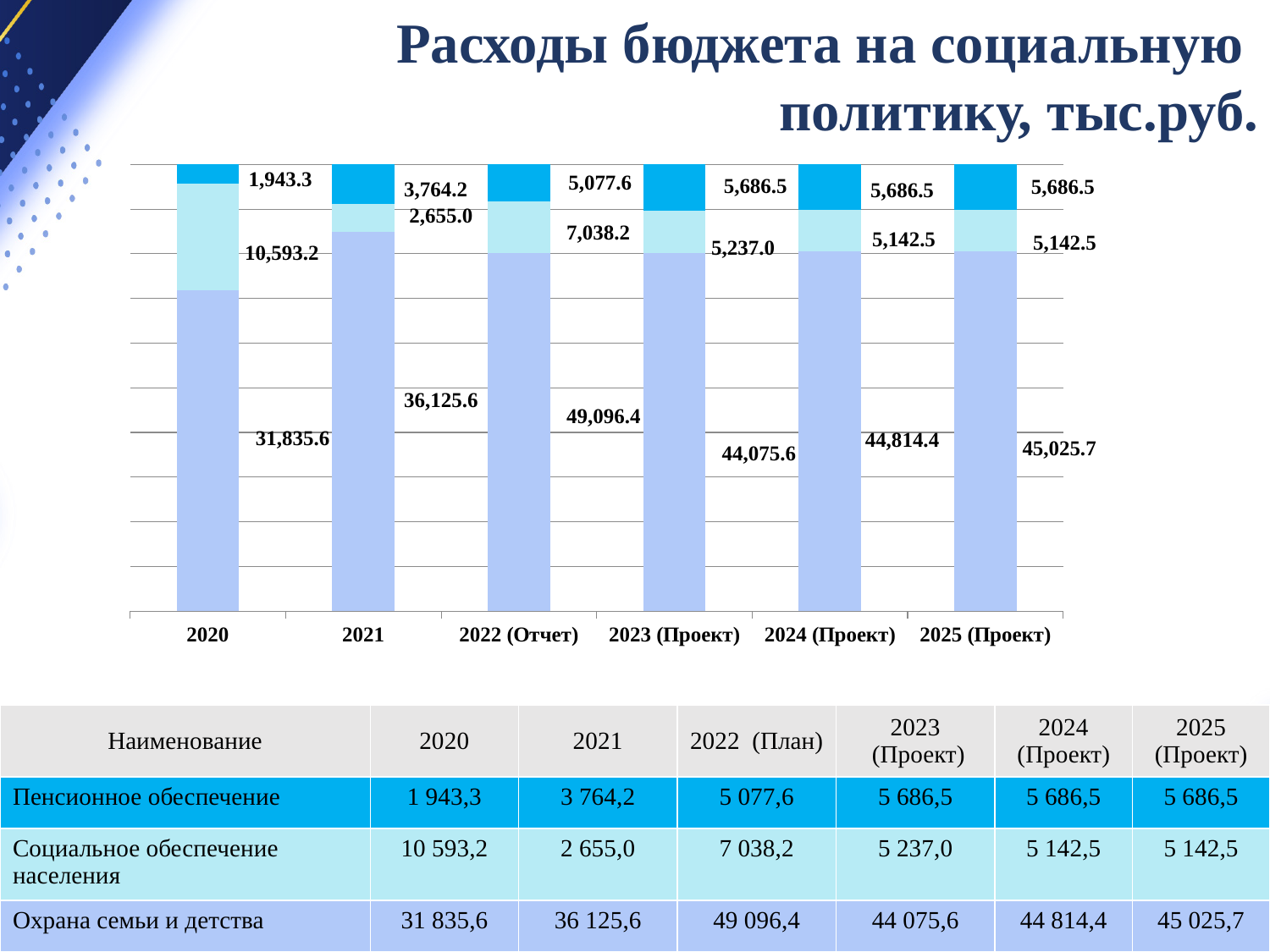
What is the total of the stacked bar for 2020? 44,372.1 What is the value of the top (dark blue) segment, Пенсионное обеспечение, for 2020? 1,943.3 What kind of chart is shown on the slide? Stacked bar chart How many year categories are shown on the x axis of the chart? 6 What is the title of the chart? Расходы бюджета на социальную политику, тыс.руб. What is the total of the stacked bar for 2025 (Проект)? 55,854.7 What is the value of the middle segment, Социальное обеспечение населения, for 2023 (Проект)? 5,237.0 In which year is the bottom segment (Охрана семьи и детства) the largest? 2022 (Отчет) In which year is the middle segment (Социальное обеспечение населения) the smallest? 2021 What is the value of the bottom segment, Охрана семьи и детства, for 2022 (Отчет)? 49,096.4 Which is larger, the bottom segment value for 2024 (Проект) or for 2023 (Проект)? 2024 (Проект) What is the difference between the bottom segment values for 2022 (Отчет) and 2021? 12,970.8